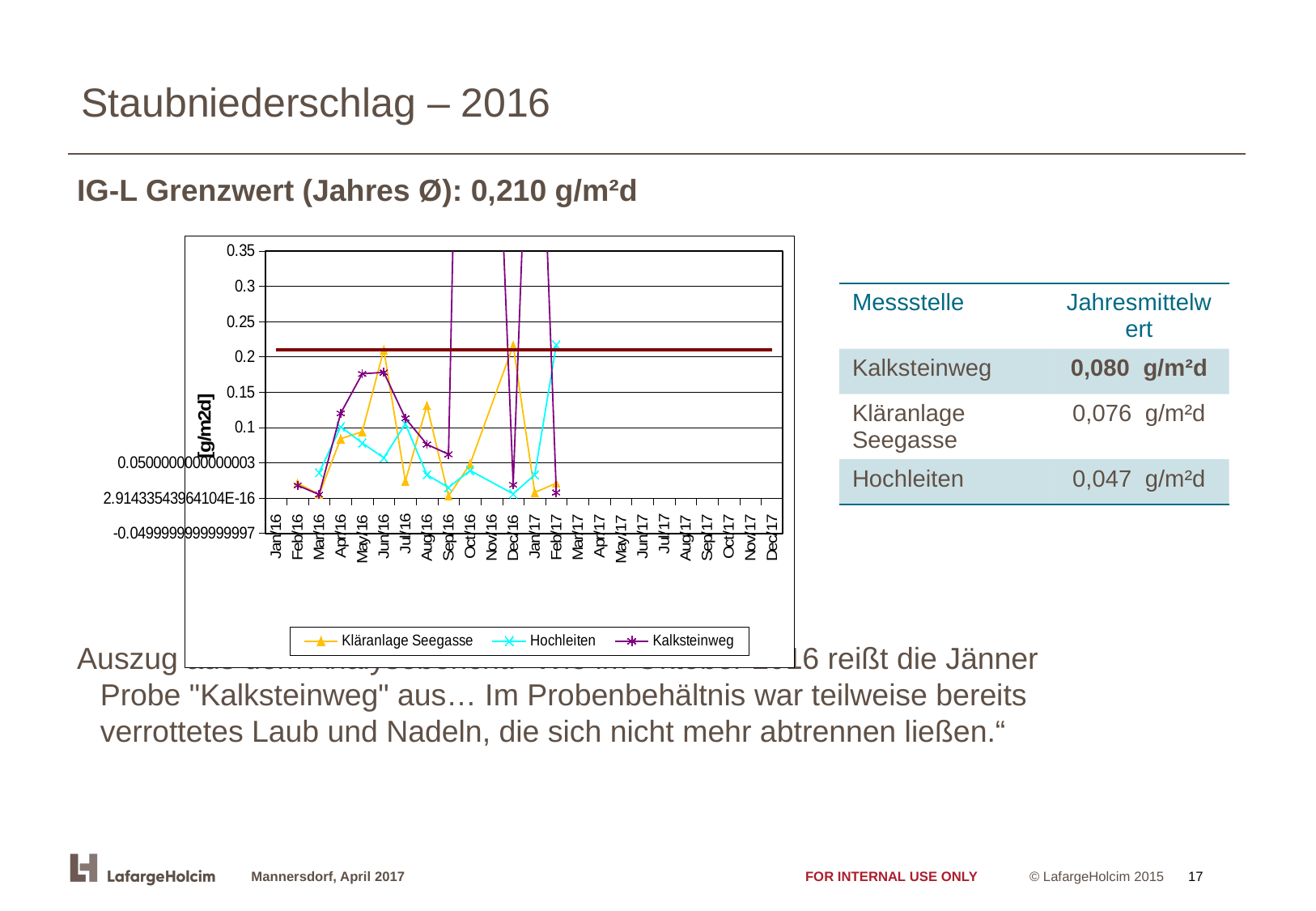
Is the value for Hochleiten in Dec'16 greater or less than 0.05? less In Apr'16, which is larger: the value for Kalksteinweg or the value for Kläranlage Seegasse? Kalksteinweg Is the value for Kalksteinweg in May'16 greater or less than 0.15? greater Which series are listed in the chart legend? Kläranlage Seegasse, Hochleiten, Kalksteinweg What kind of chart is shown on the slide? Line chart Which series has the highest value in May'16? Kalksteinweg How many months are shown along the x axis of the chart? 24 Does the Kalksteinweg series rise or fall from Mar'16 to May'16? Rise How many series does the chart legend list? 3 Is the value for Hochleiten in Feb'17 greater or less than 0.15? greater What is the label of the chart's vertical axis? [g/m2d]